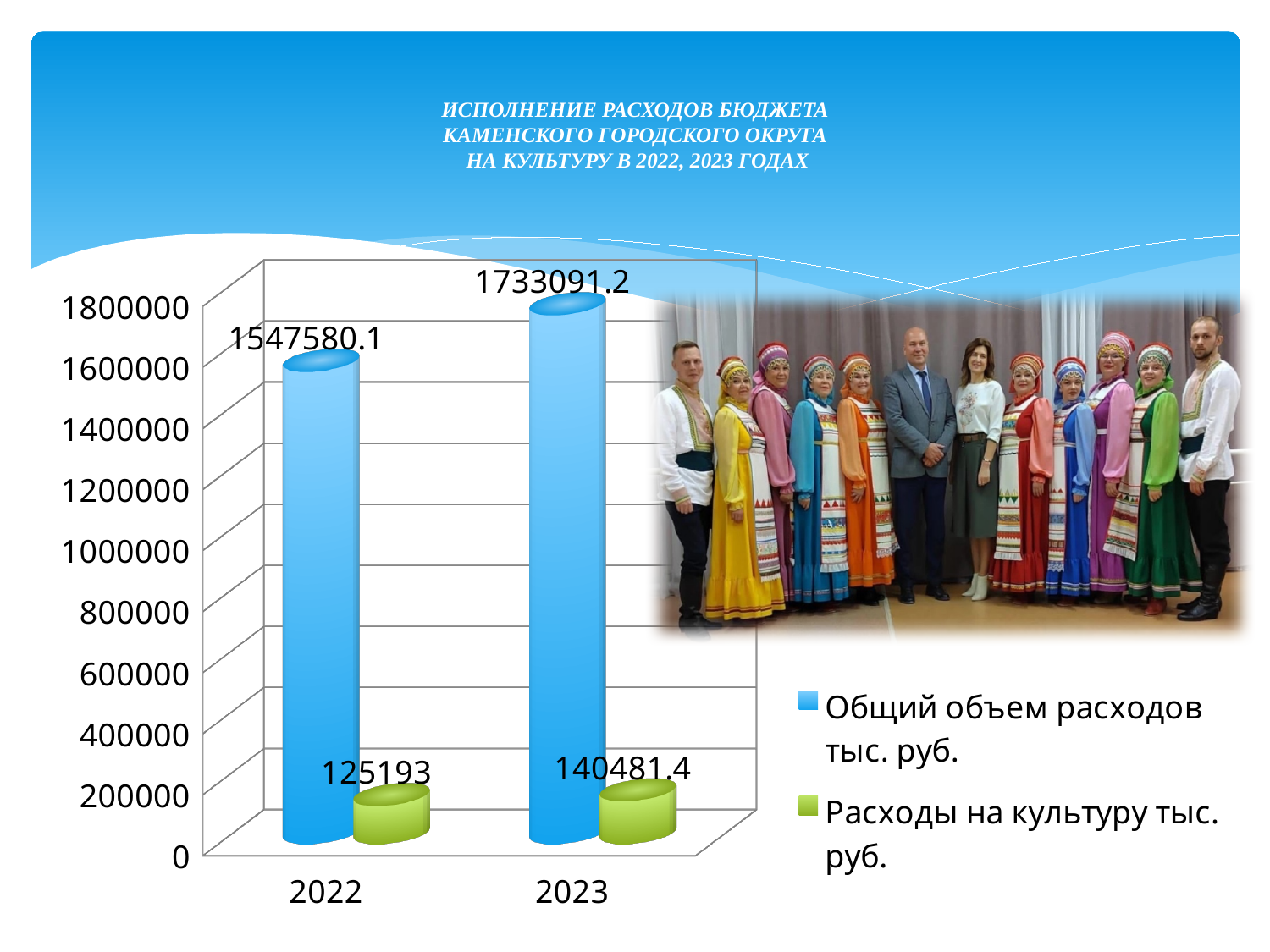
What is the value of "Расходы на культуру тыс. руб." for 2023? 140481.4 What is the value of "Расходы на культуру тыс. руб." for 2022? 125193 By how much did "Общий объем расходов тыс. руб." increase from 2022 to 2023? 185511.1 What is the difference between "Расходы на культуру тыс. руб." in 2023 and in 2022? 15288.4 In which year is "Расходы на культуру тыс. руб." lowest? 2022 What is the value of "Общий объем расходов тыс. руб." for 2022? 1547580.1 What type of chart is shown on the slide? Bar chart In which year is "Общий объем расходов тыс. руб." highest? 2023 Which is larger: "Расходы на культуру тыс. руб." in 2022 or in 2023? 2023 How many years are shown on the x axis of the chart? 2 How many series does the chart legend list? 2 What is the value of "Общий объем расходов тыс. руб." for 2023? 1733091.2